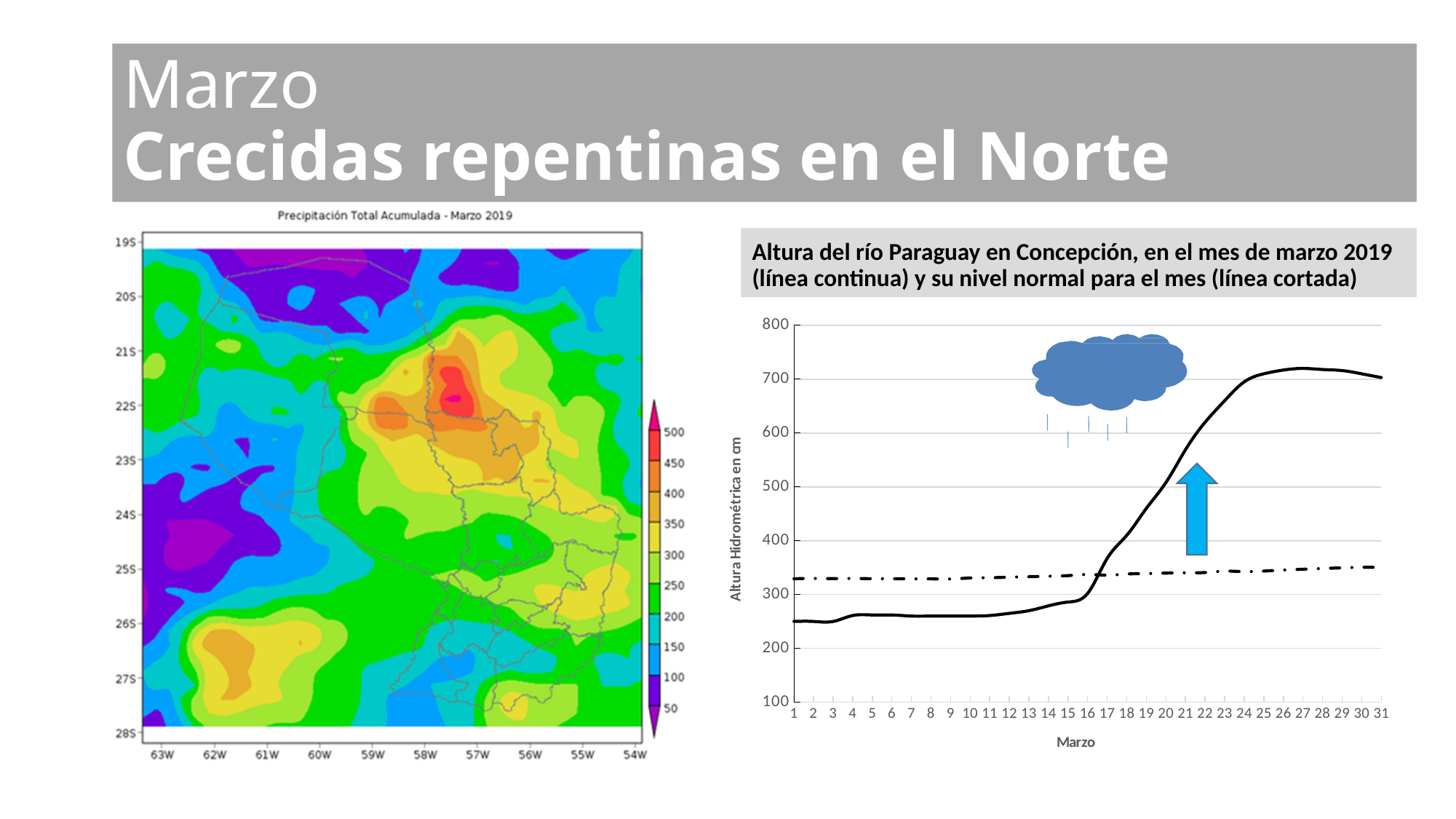
What is the y-axis label of the river height chart on the right? Altura Hidrométrica en cm In the river height chart on the right, is the value of the solid line on day 31 greater or less than 600? greater In the river height chart on the right, is the value of the solid line on day 10 greater or less than 300? less What is the title of the map chart on the left of the slide? Precipitación Total Acumulada - Marzo 2019 In the river height chart on the right, is the value of the solid line on day 20 greater or less than 400? greater How many days are marked on the x axis of the river height chart on the right? 31 In the river height chart on the right, on day 31, which line has the higher value: the solid line or the dashed line? the solid line In the river height chart on the right, does the solid line overall rise or fall from day 1 to day 31? rise What kind of chart is the chart on the right of the slide, titled 'Altura del río Paraguay en Concepción'? line chart In the river height chart on the right, on day 5, which line has the higher value: the solid line or the dashed line? the dashed line